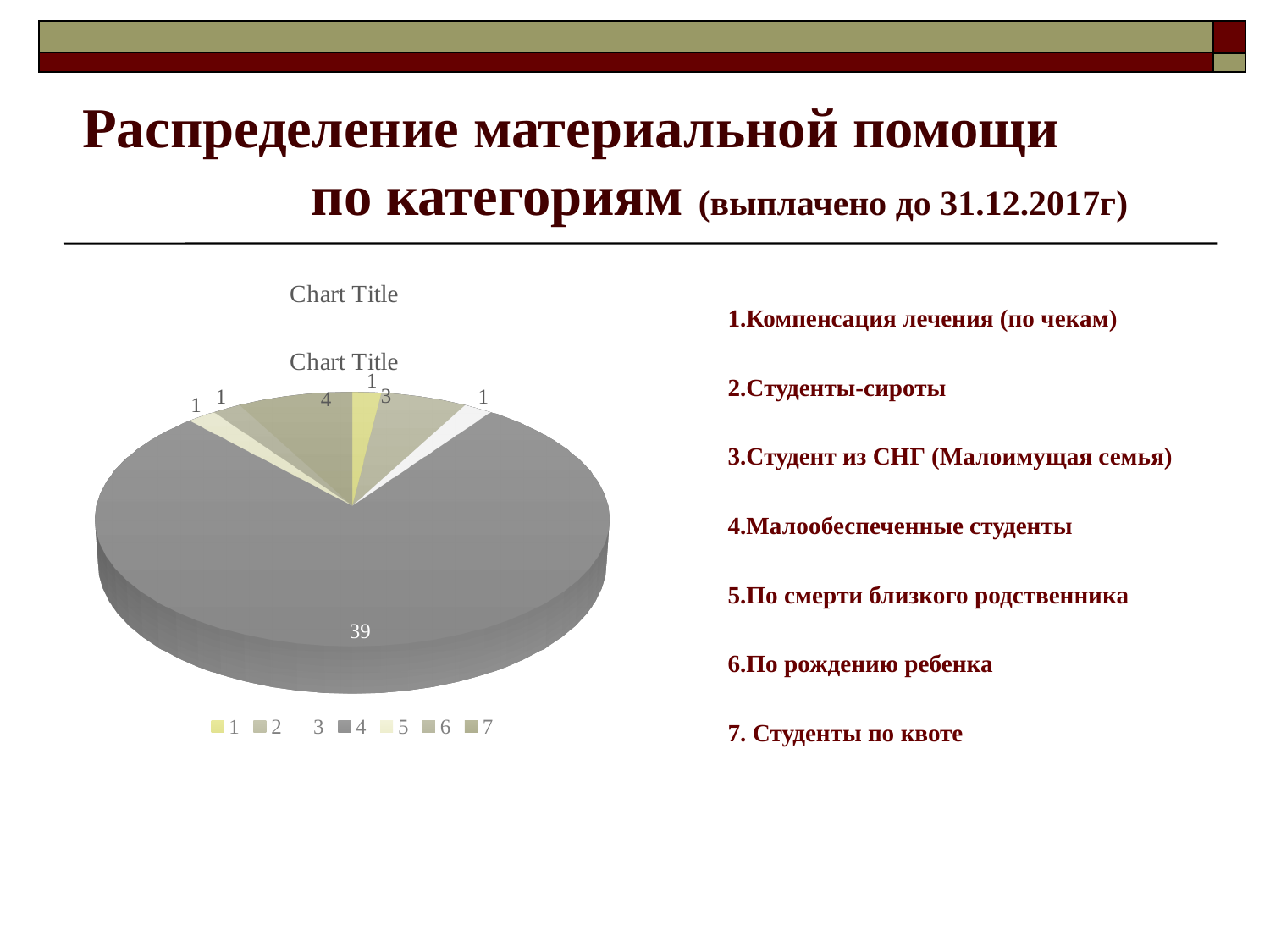
What is the value shown for category 2 in the pie chart? 3 What is the value shown for category 7 in the pie chart? 4 How many entries does the legend of the pie chart list? 7 Which legend category has the largest slice in the pie chart? 4 What is the difference between the slice with value 39 and the slice with value 4? 35 What share of the pie does the slice with value 39 represent? 78% What is the value shown for category 4 in the pie chart? 39 How many slices does the pie chart have? 7 What title is printed above the pie chart? Chart Title What is the value of the largest slice in the pie chart? 39 What type of chart is shown on the slide? pie chart What is the total of all the slice values in the pie chart? 50